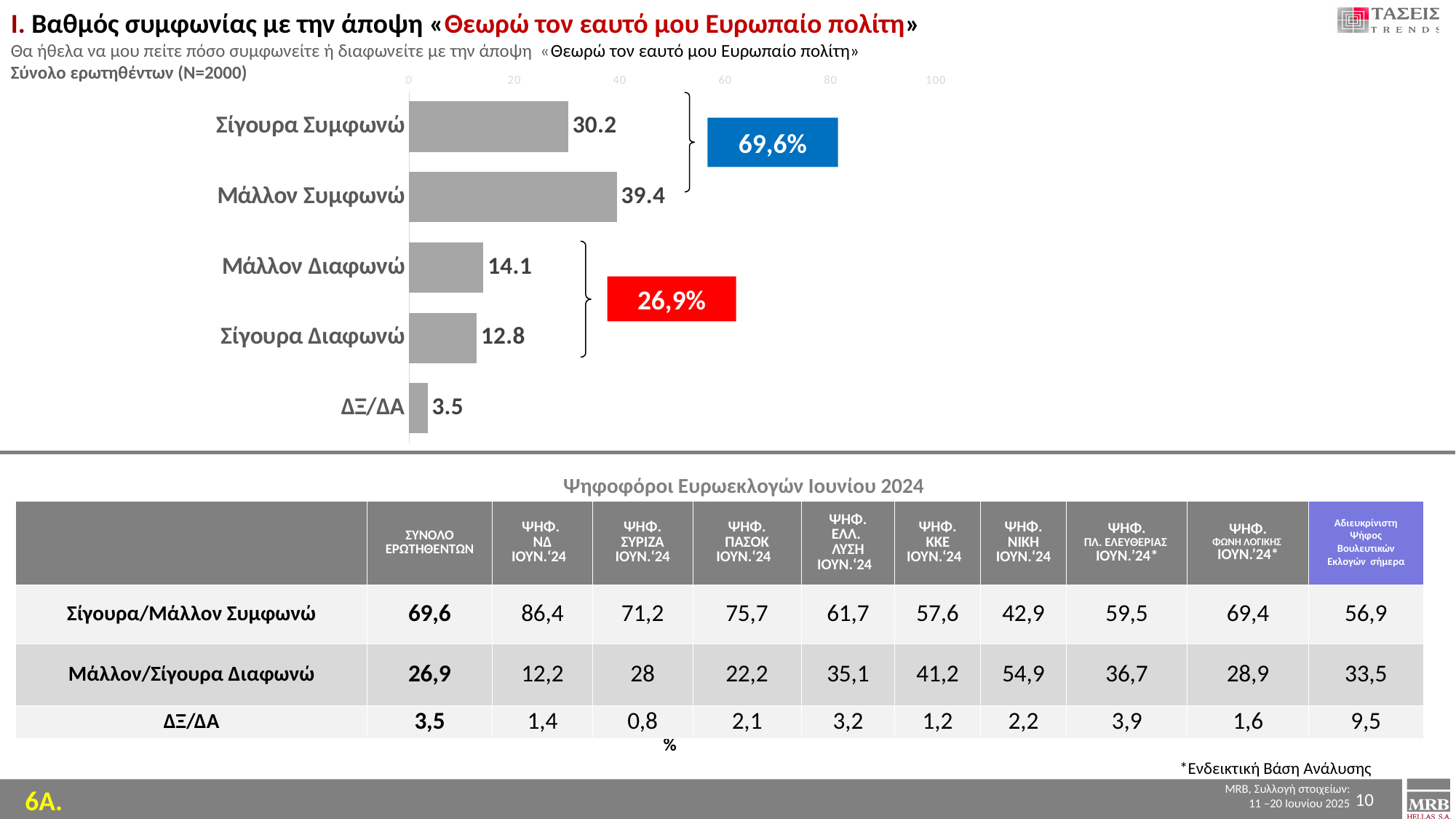
What combined percentage is shown in the blue box next to the two «Συμφωνώ» bars? 69,6% What is the value for «Σίγουρα Συμφωνώ» in the bar chart? 30.2 Which category has the highest value in the bar chart? Μάλλον Συμφωνώ Is the value for «Σίγουρα Συμφωνώ» greater or less than 20? greater What is the difference between the values for «Μάλλον Συμφωνώ» and «Σίγουρα Συμφωνώ»? 9.2 How many categories are shown in the bar chart? 5 What is the value for «ΔΞ/ΔΑ» in the bar chart? 3.5 Which is larger: the value for «Μάλλον Διαφωνώ» or «Σίγουρα Διαφωνώ»? Μάλλον Διαφωνώ Which category has the lowest value in the bar chart? ΔΞ/ΔΑ What is the value for «Μάλλον Συμφωνώ» in the bar chart? 39.4 What is the difference between the values for «Μάλλον Διαφωνώ» and «Σίγουρα Διαφωνώ»? 1.3 What kind of chart is shown at the top of the slide? bar chart